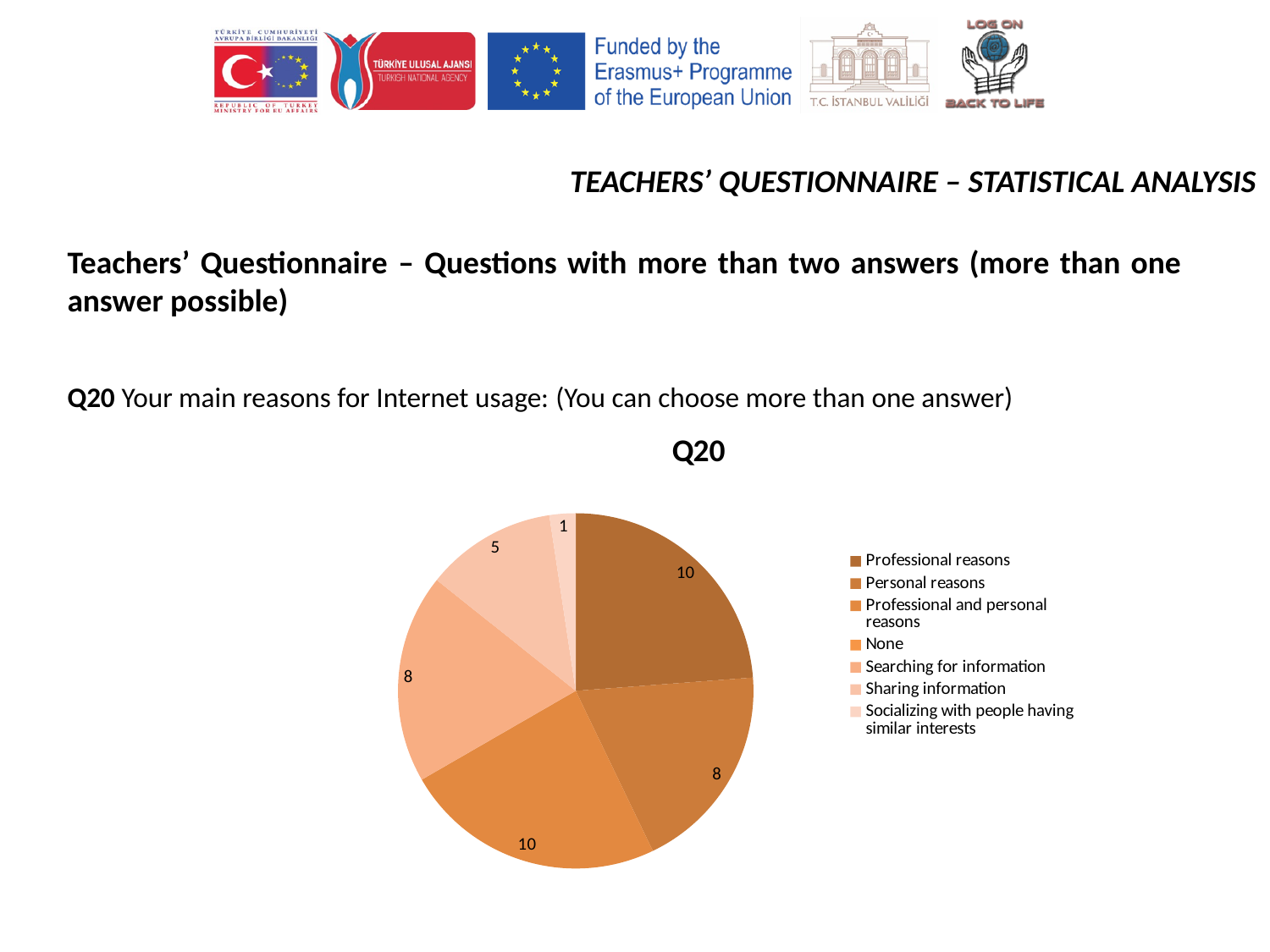
What is the title of the chart? Q20 What is the value of the smallest slice in the pie chart? 1 Which legend entry is listed last in the chart legend? Socializing with people having similar interests What kind of chart is shown on the slide? pie chart What is the value for Personal reasons? 8 How many slices with data labels are visible in the pie chart? 6 What is the difference between the value for Professional reasons and the value for Personal reasons? 2 What is the sum of all the labelled slice values in the pie chart? 42 What is the value for Professional reasons? 10 How many entries does the chart legend list? 7 Which is larger, the value for Professional reasons or the value for Personal reasons? Professional reasons What is the value for Professional and personal reasons? 10